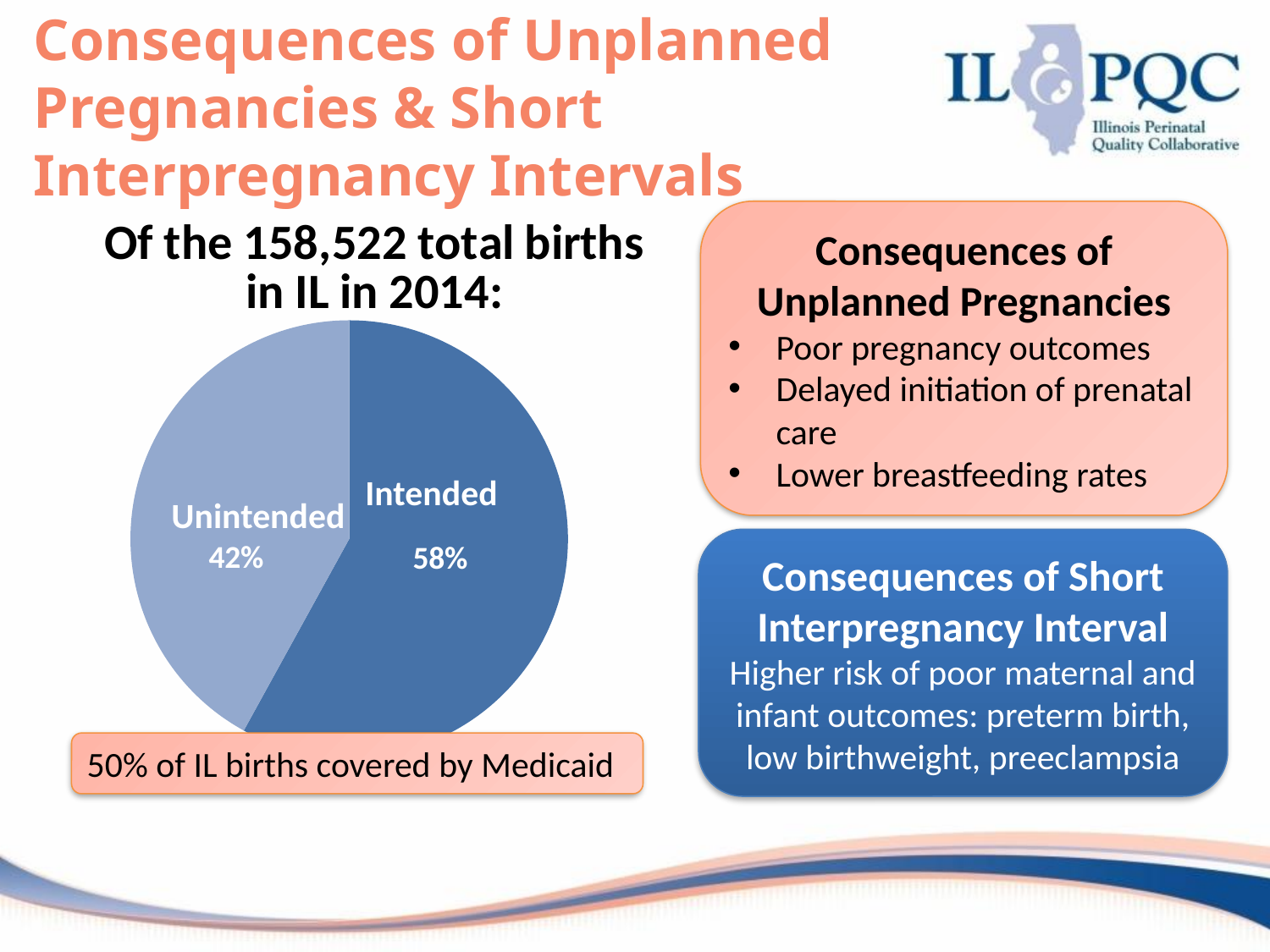
Which slice of the pie chart is the largest? Intended What is the title of the pie chart? Of the 158,522 total births in IL in 2014: Which slice of the pie chart is the smallest? Unintended What is the difference in percentage points between the Intended and Unintended slices? 16 Which slice of the pie chart is shown in the lighter blue colour? Unintended Which is larger in the pie chart, Intended or Unintended? Intended What kind of chart is shown on the slide? pie chart What percentage of births in the pie chart are labelled Intended? 58% Is the Unintended share of the pie chart greater or less than 50%? less What percentage of births in the pie chart are labelled Unintended? 42% How many slices does the pie chart have? 2